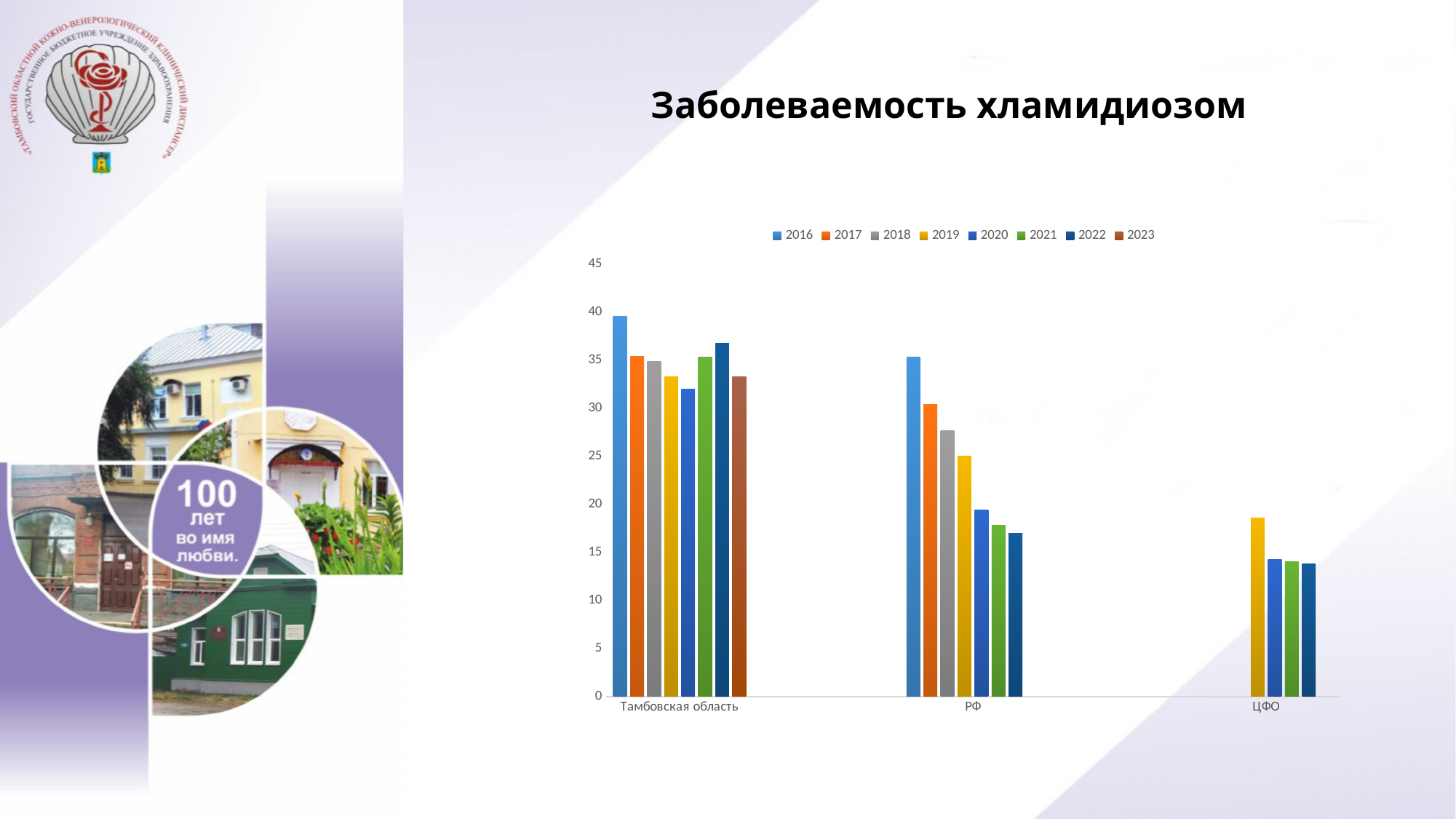
Is the value for 2016 in Тамбовская область greater or less than 35? greater Which is larger for 2019: the value for Тамбовская область or the value for РФ? Тамбовская область How many categories are shown on the x axis? 3 Which year has the highest value for Тамбовская область? 2016 What kind of chart is shown on the slide? bar chart Is the value for 2020 in РФ greater or less than 20? less How many series does the legend list? 8 What is the title of the chart? Заболеваемость хламидиозом Which category has the lowest value for 2022? ЦФО Is the value for 2019 in ЦФО greater or less than 15? greater Which year has the lowest value for РФ? 2022 Do the values for РФ rise or fall from 2016 to 2022? fall